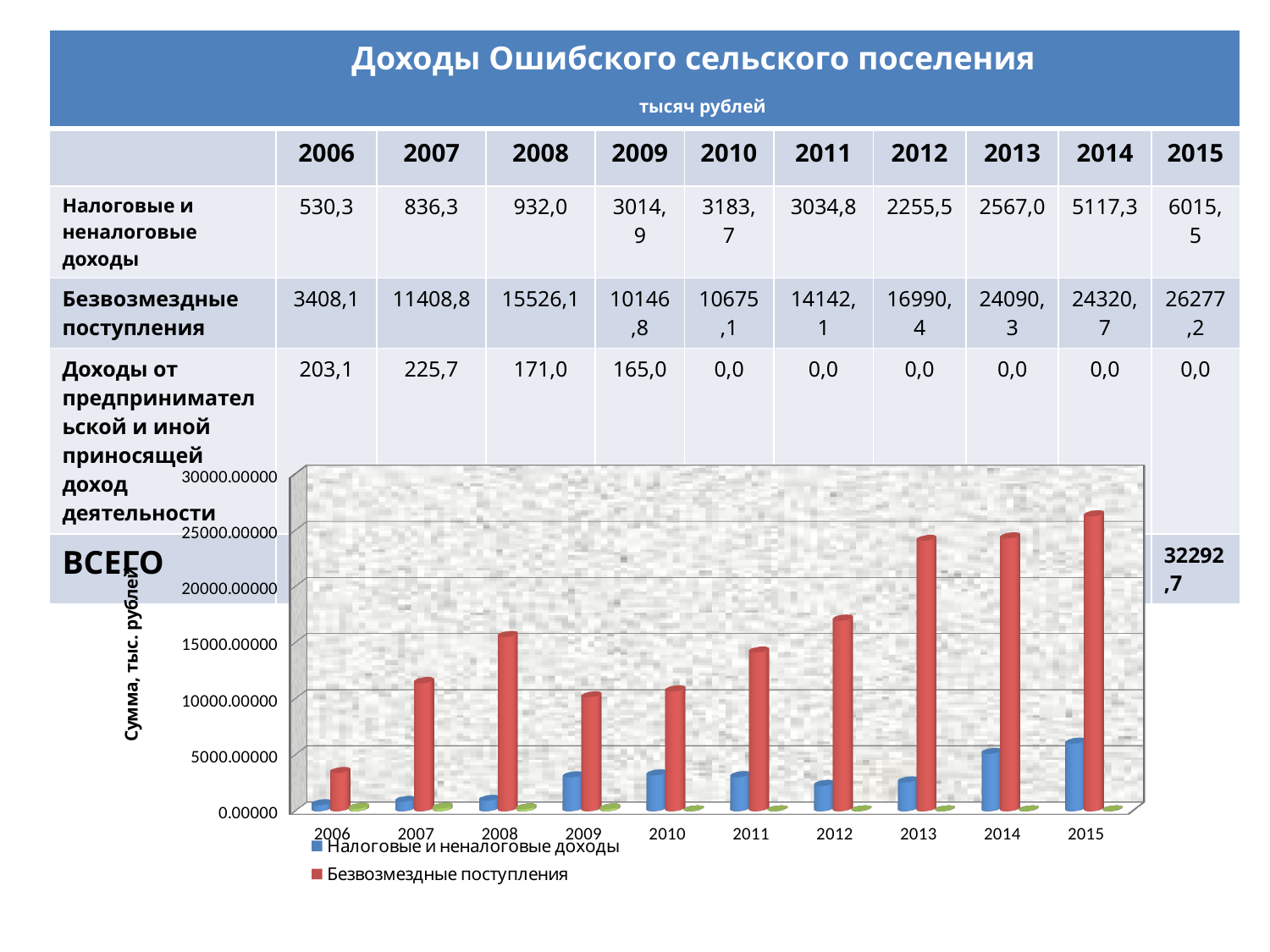
In which year is the value for Безвозмездные поступления highest? 2015 In which year is the value for Безвозмездные поступления lowest? 2006 Is the value for Безвозмездные поступления in 2012 greater or less than 15000? greater Do the values for Безвозмездные поступления rise or fall from 2010 to 2015? rise Which is larger for Безвозмездные поступления: the value in 2012 or in 2013? 2013 How many years are shown along the x axis of the chart? 10 What is the label on the vertical axis of the chart? Сумма, тыс. рублей Is the value for Безвозмездные поступления in 2015 greater or less than 25000? greater Is the value for Налоговые и неналоговые доходы in 2011 greater or less than 5000? less In which year is the value for Налоговые и неналоговые доходы highest? 2015 What kind of chart is shown on the slide? bar chart How many series does the chart legend list? 2